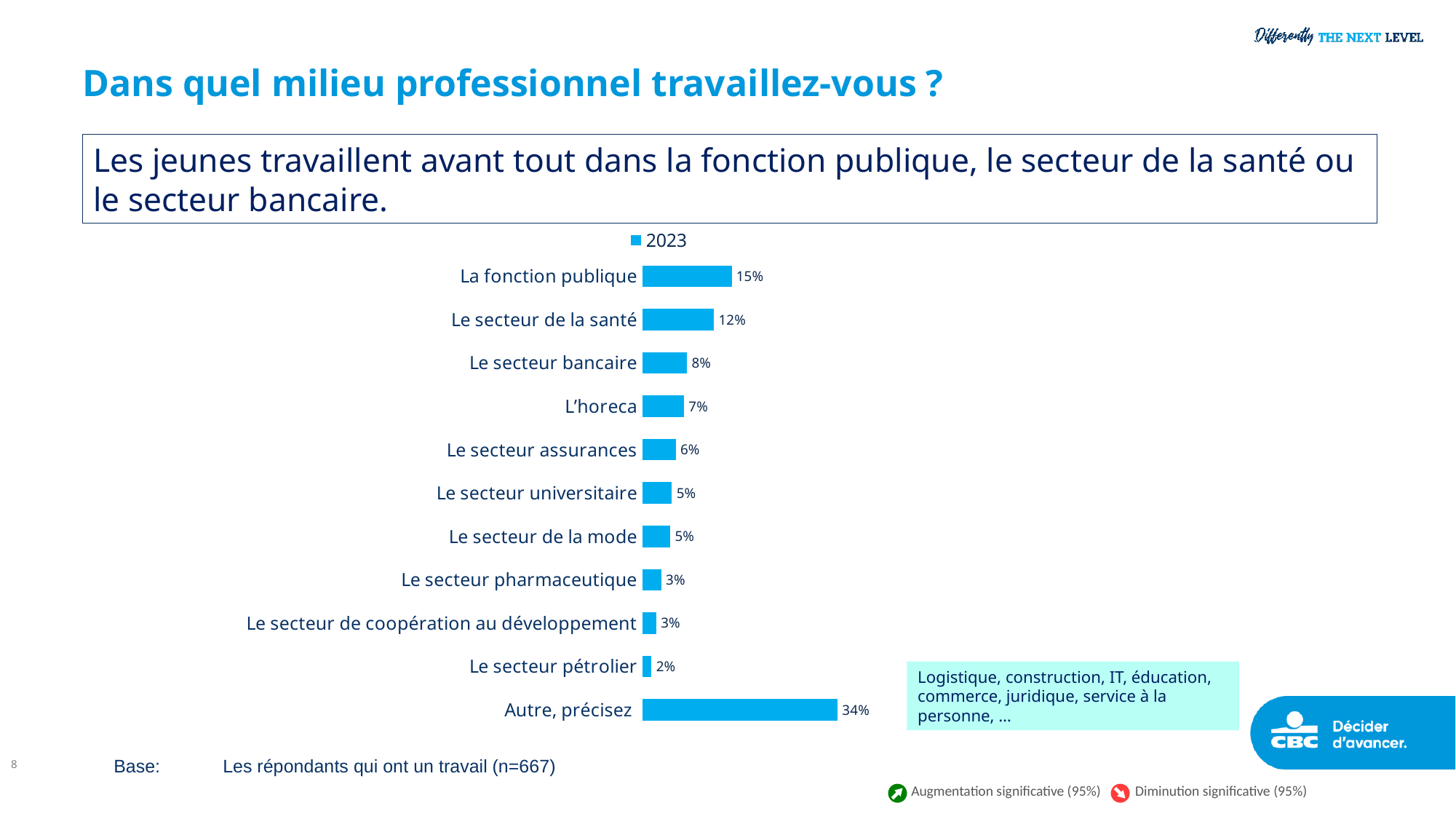
What is the value for Autre, précisez? 34% What is the value for Le secteur de la santé? 12% Which category has the highest value? Autre, précisez How many categories are shown in the chart? 11 Which is larger, L'horeca or Le secteur assurances? L'horeca What kind of chart is shown on the slide? Bar chart Which category has the lowest value? Le secteur pétrolier What is the value for Le secteur pétrolier? 2% What is the difference between La fonction publique and Le secteur bancaire? 7% What series name is shown in the legend? 2023 How many series does the legend list? 1 What is the value for La fonction publique? 15%